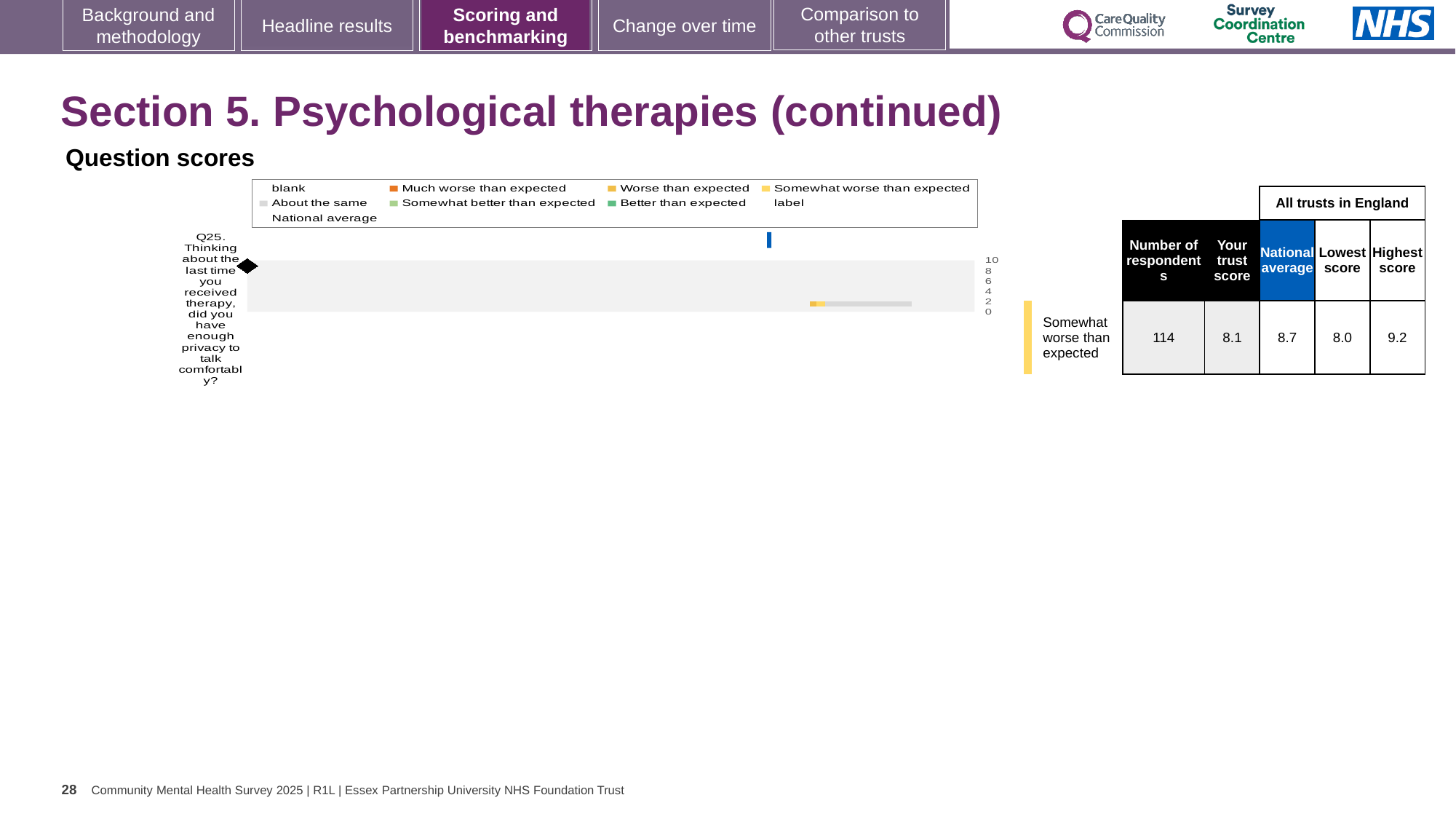
What is the difference between the national average and the trust's score for Q25? 0.6 What is the national average score for Q25 shown on the slide? 8.7 What kind of chart is used to show the Q25 question score? Bar chart Which legend entry is shown with an orange marker in the question scores chart? Much worse than expected What is the difference between the highest and lowest scores across all trusts in England for Q25? 1.2 What is the highest score among all trusts in England for Q25? 9.2 Which is larger for Q25: the trust's score or the national average? National average What benchmark category is the trust's Q25 score placed in? Somewhat worse than expected How many respondents answered Q25 according to the table? 114 What is the lowest score among all trusts in England for Q25? 8.0 What is the trust's score for Q25 about having enough privacy to talk comfortably during therapy? 8.1 How many questions are plotted in the question scores chart on this slide? 1